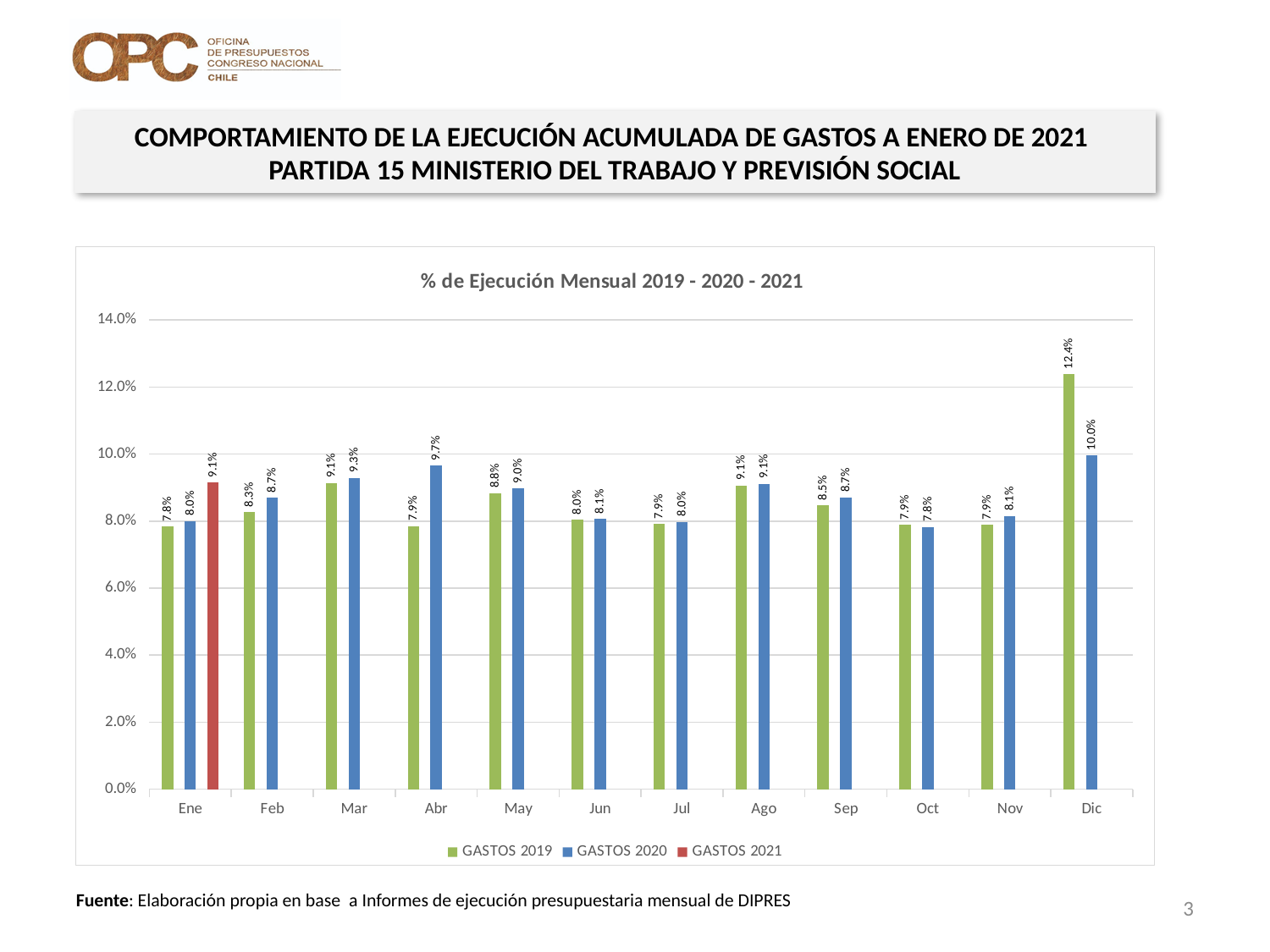
What is the value for GASTOS 2019 in Dic? 12.4% Is the value for GASTOS 2019 in Dic greater or less than 12.0%? greater In which month is the GASTOS 2019 value highest? Dic What is the value for GASTOS 2021 in Ene? 9.1% In which month is the GASTOS 2020 value lowest? Oct What is the title of the chart? % de Ejecución Mensual 2019 - 2020 - 2021 How many series does the legend list? 3 What is the value for GASTOS 2020 in Abr? 9.7% What is the difference between GASTOS 2019 and GASTOS 2020 in Dic? 2.4% How many months are shown on the x axis? 12 What kind of chart is shown? bar chart Which is larger in Abr, GASTOS 2019 or GASTOS 2020? GASTOS 2020